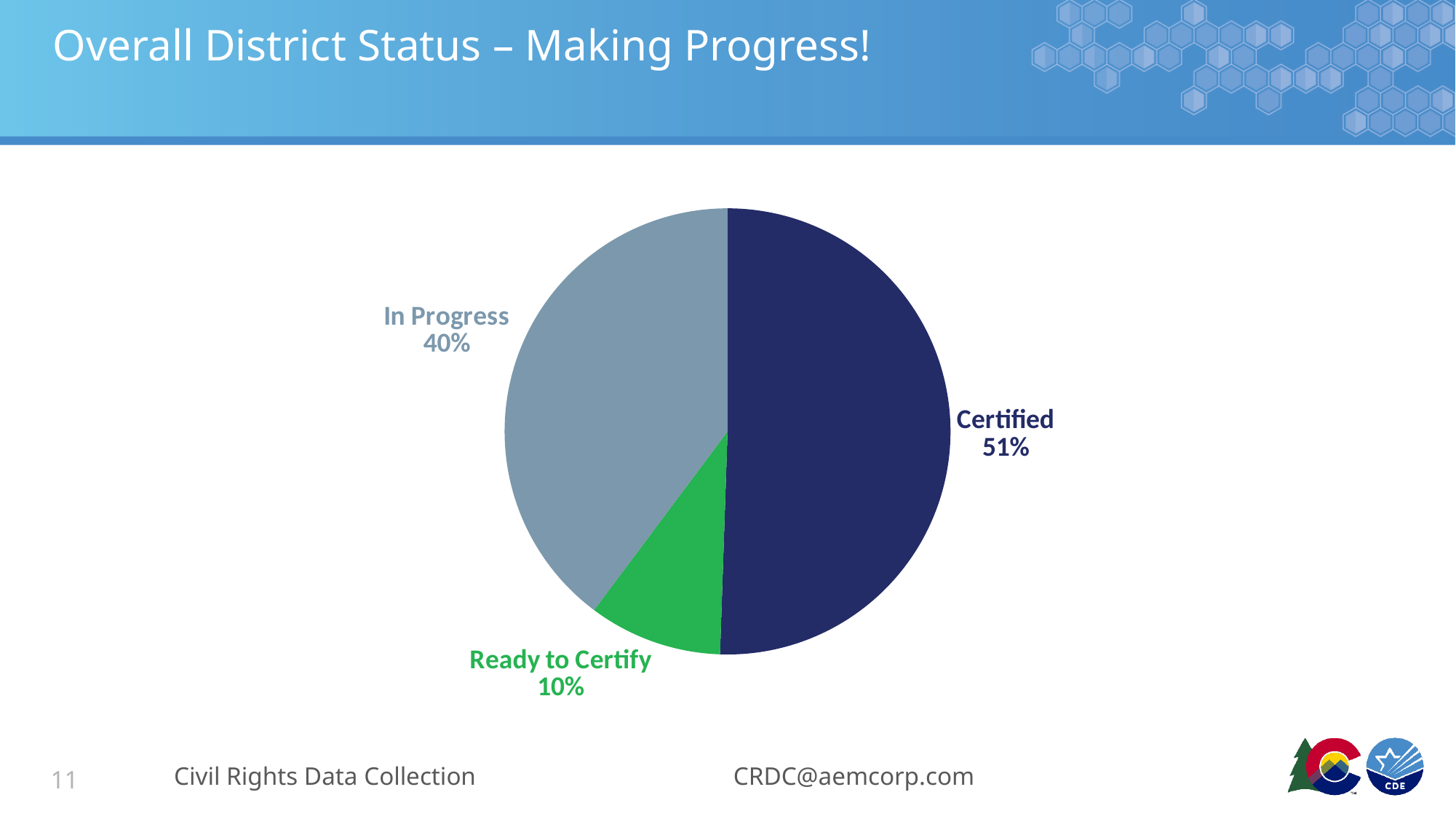
What is the difference in percentage points between In Progress and Ready to Certify? 30 Which is larger, the In Progress share or the Ready to Certify share? In Progress What is the title of the slide containing the pie chart? Overall District Status – Making Progress! How many slices does the pie chart have? 3 What is the difference in percentage points between Certified and In Progress? 11 Which status has the smallest share of the pie? Ready to Certify What percentage of districts are In Progress? 40% What percentage of districts are Certified? 51% What kind of chart is shown on the slide? pie chart Which status has the largest share of the pie? Certified What percentage of districts are Ready to Certify? 10% What colour is the Ready to Certify slice? green